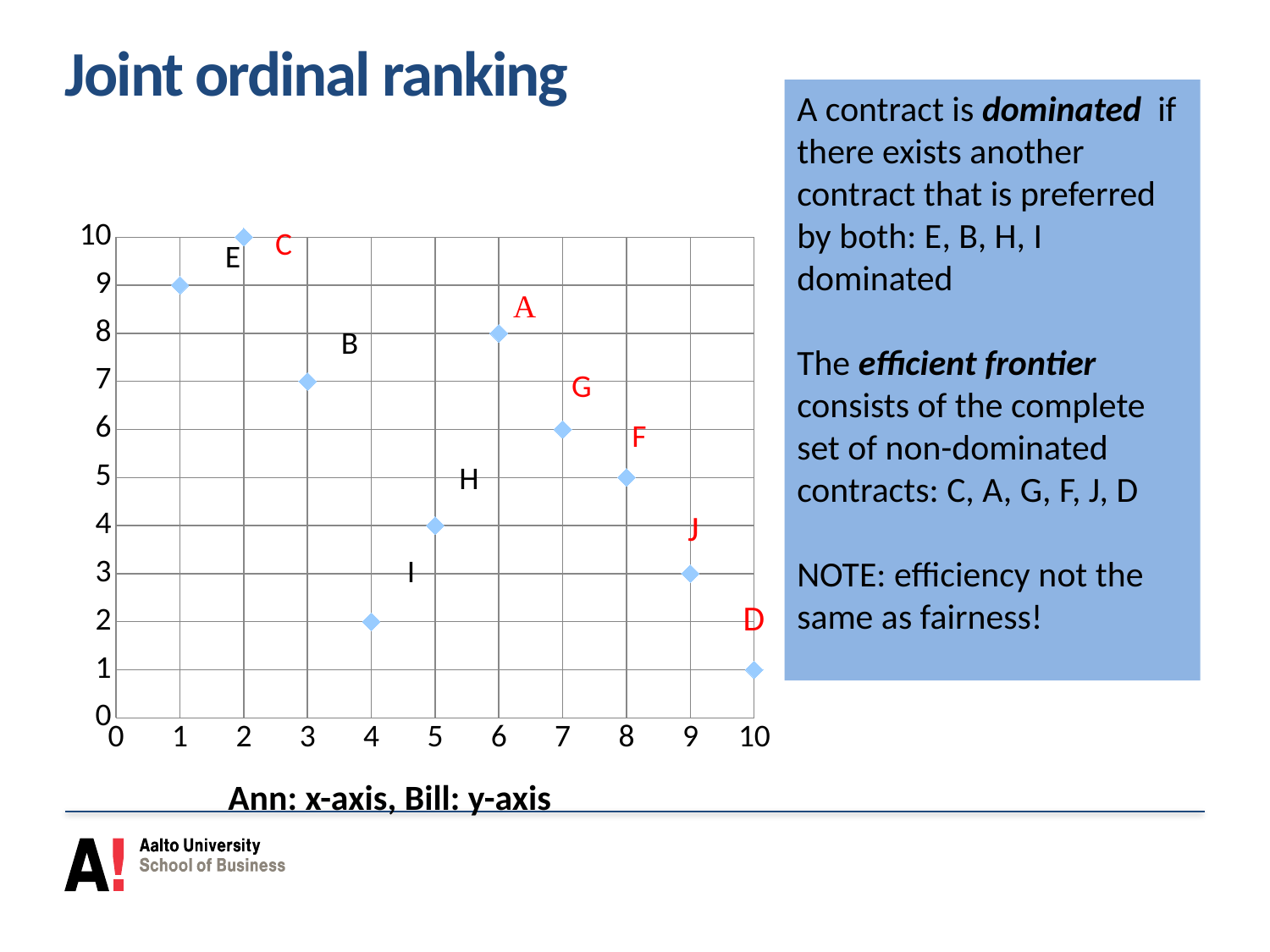
What is the difference between the y-axis values of points A and G? 2 What kind of chart is shown on the slide? Scatter plot Which labeled point has the lowest y-axis (Bill) value? D Which labeled point has the highest y-axis (Bill) value? C Which point has the larger y-axis value, B or H? B What is the x-axis (Ann) value of point D? 10 How many labeled points are plotted on the chart? 10 What is the y-axis (Bill) value of point C? 10 What are the coordinates of point H? (5, 4) Which labeled point has the lowest x-axis (Ann) value? E What is the y-axis value of point I? 2 Is the y-axis value for point J greater or less than 5? less